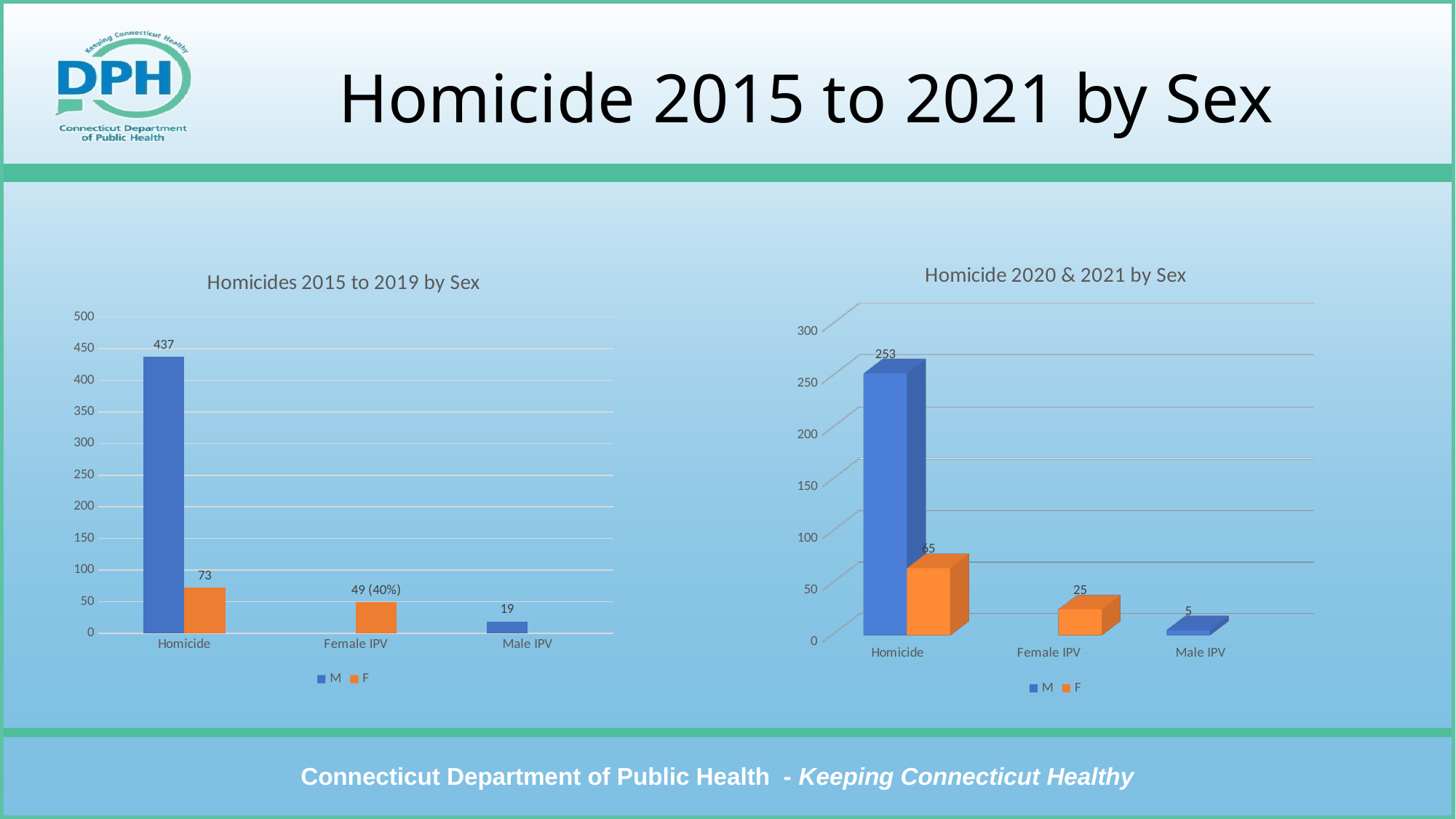
In the 'Homicides 2015 to 2019 by Sex' chart, what is the value for M in the Homicide category? 437 How many series does the legend of the 'Homicide 2020 & 2021 by Sex' chart list? 2 In the 'Homicide 2020 & 2021 by Sex' chart, what is the value for M in the Male IPV category? 5 What type of chart is the 'Homicides 2015 to 2019 by Sex' chart? bar chart In the 'Homicides 2015 to 2019 by Sex' chart, what is the value for M in the Male IPV category? 19 In the 'Homicide 2020 & 2021 by Sex' chart, which category has the highest M value? Homicide In the 'Homicides 2015 to 2019 by Sex' chart, what is the difference between the M and F values in the Homicide category? 364 In the 'Homicides 2015 to 2019 by Sex' chart, how many categories are shown on the x axis? 3 In the 'Homicide 2020 & 2021 by Sex' chart, is the F value for Homicide larger or smaller than the F value for Female IPV? larger In the 'Homicide 2020 & 2021 by Sex' chart, what is the value for F in the Female IPV category? 25 In the 'Homicides 2015 to 2019 by Sex' chart, what is the value for F in the Homicide category? 73 In the 'Homicide 2020 & 2021 by Sex' chart, what is the value for M in the Homicide category? 253